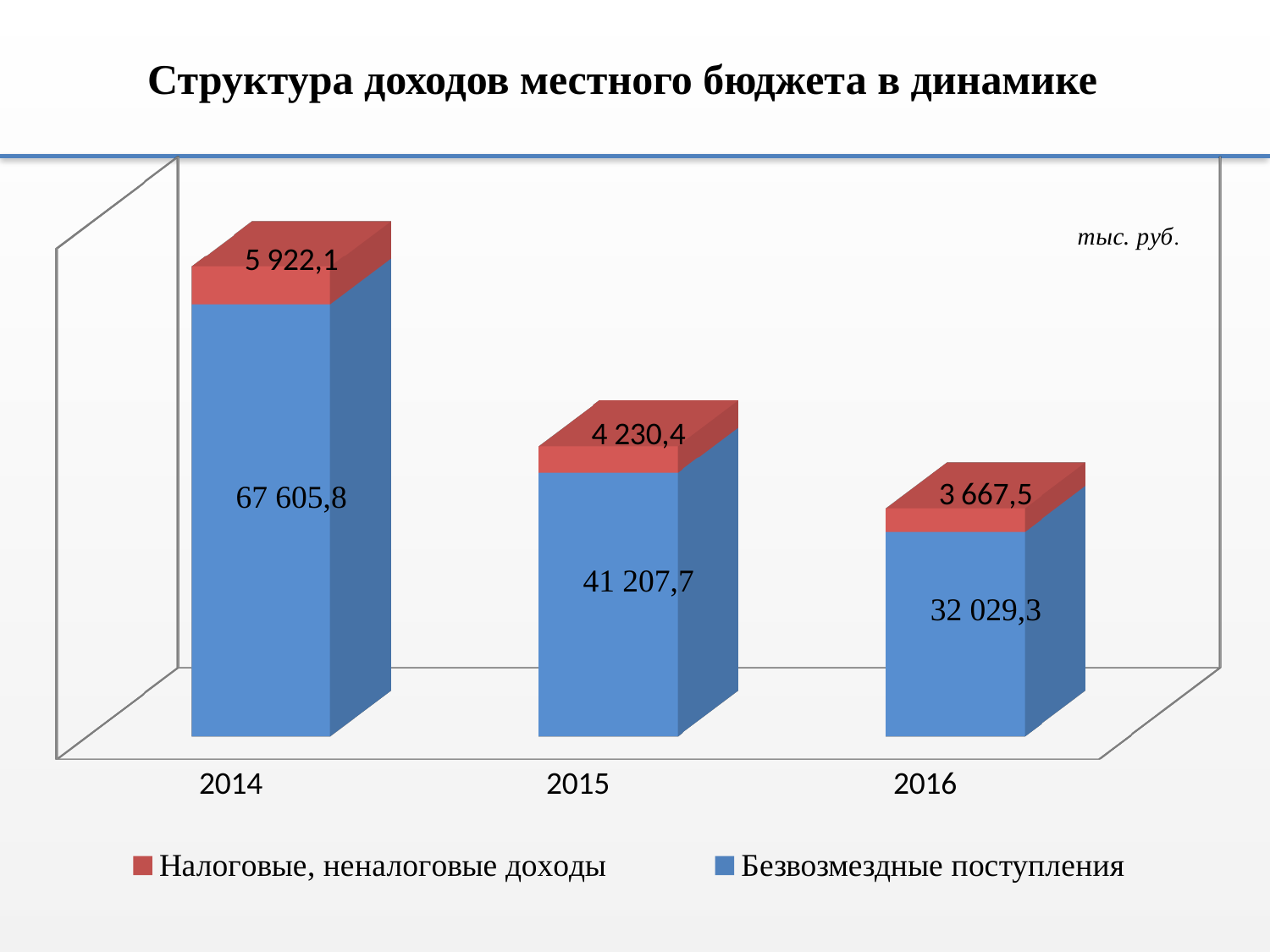
What is the value of Безвозмездные поступления for 2014? 67 605,8 Which year has the highest value of Безвозмездные поступления? 2014 What is the value of Безвозмездные поступления for 2016? 32 029,3 Which year has the lowest value of Налоговые, неналоговые доходы? 2016 What is the value of Налоговые, неналоговые доходы for 2016? 3 667,5 What is the difference between Безвозмездные поступления in 2014 and 2015? 26 398,1 What is the value of Налоговые, неналоговые доходы for 2015? 4 230,4 What is the total of the stacked bar for 2015? 45 438,1 How many years are shown on the x axis? 3 Which is larger: Налоговые, неналоговые доходы in 2014 or in 2016? 2014 How many series does the legend list? 2 What kind of chart is shown on the slide? Stacked bar chart